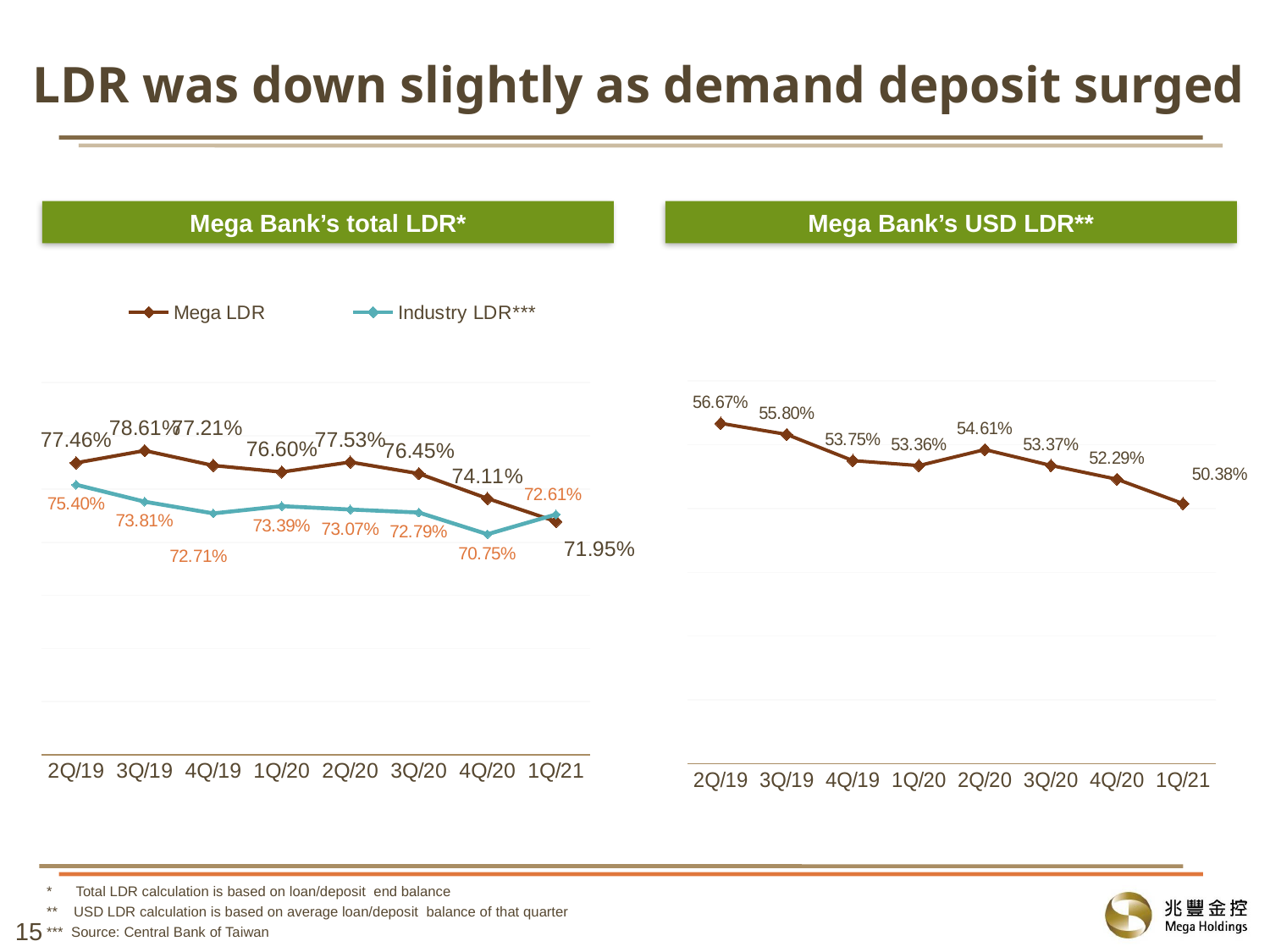
In the Mega Bank's USD LDR chart, what is the value for 2Q/20? 54.61% In the Mega Bank's total LDR chart, which is larger in 1Q/21: Mega LDR or Industry LDR? Industry LDR In the Mega Bank's total LDR chart, in which quarter is the Mega LDR highest? 3Q/19 In the Mega Bank's total LDR chart, by how many percentage points did the Mega LDR fall from 2Q/19 to 1Q/21? 5.51 percentage points In the Mega Bank's USD LDR chart, what is the difference between the 2Q/19 and 1Q/21 values? 6.29 percentage points In the Mega Bank's total LDR chart, what is the Mega LDR value for 1Q/21? 71.95% In the Mega Bank's total LDR chart, what is the Industry LDR value for 4Q/20? 70.75% In the Mega Bank's USD LDR chart, in which quarter is the USD LDR lowest? 1Q/21 How many series does the legend of the Mega Bank's total LDR chart list? 2 In the Mega Bank's USD LDR chart, does the USD LDR generally rise or fall from 2Q/19 to 1Q/21? Fall How many quarters are plotted in the Mega Bank's USD LDR chart? 8 What kind of chart is the Mega Bank's USD LDR chart? Line chart